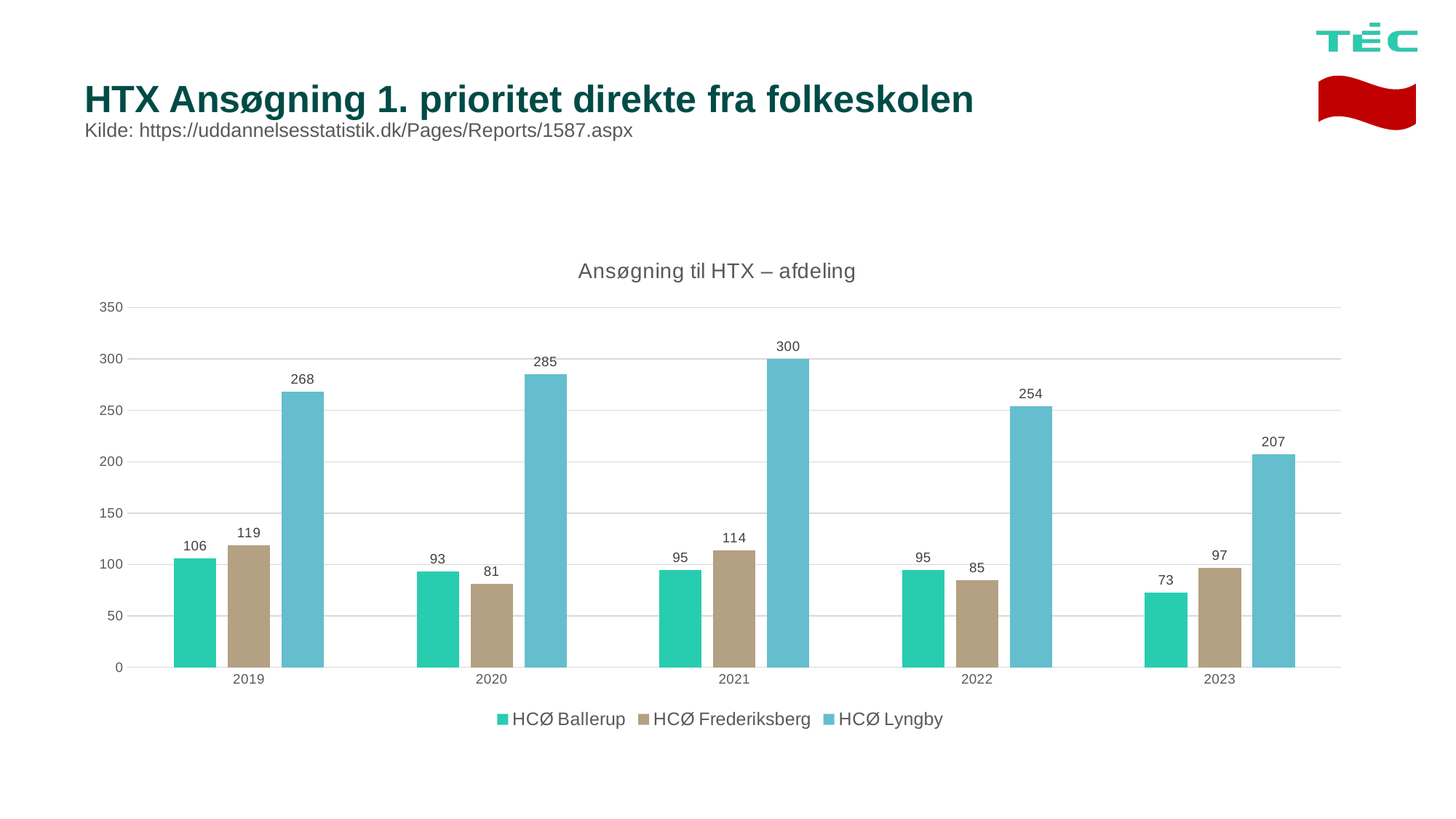
What is the value for HCØ Frederiksberg in 2020? 81 What is the value for HCØ Ballerup in 2023? 73 What kind of chart is shown on the slide? bar chart Is the value for HCØ Lyngby in 2023 greater or less than 250? less What is the value for HCØ Lyngby in 2021? 300 How many series does the legend list? 3 In which year is the HCØ Lyngby value highest? 2021 How many years are shown on the x axis? 5 What is the title of the chart? Ansøgning til HTX – afdeling Which is larger in 2022: HCØ Ballerup or HCØ Frederiksberg? HCØ Ballerup In which year is the HCØ Ballerup value lowest? 2023 What is the difference between HCØ Lyngby and HCØ Ballerup in 2019? 162